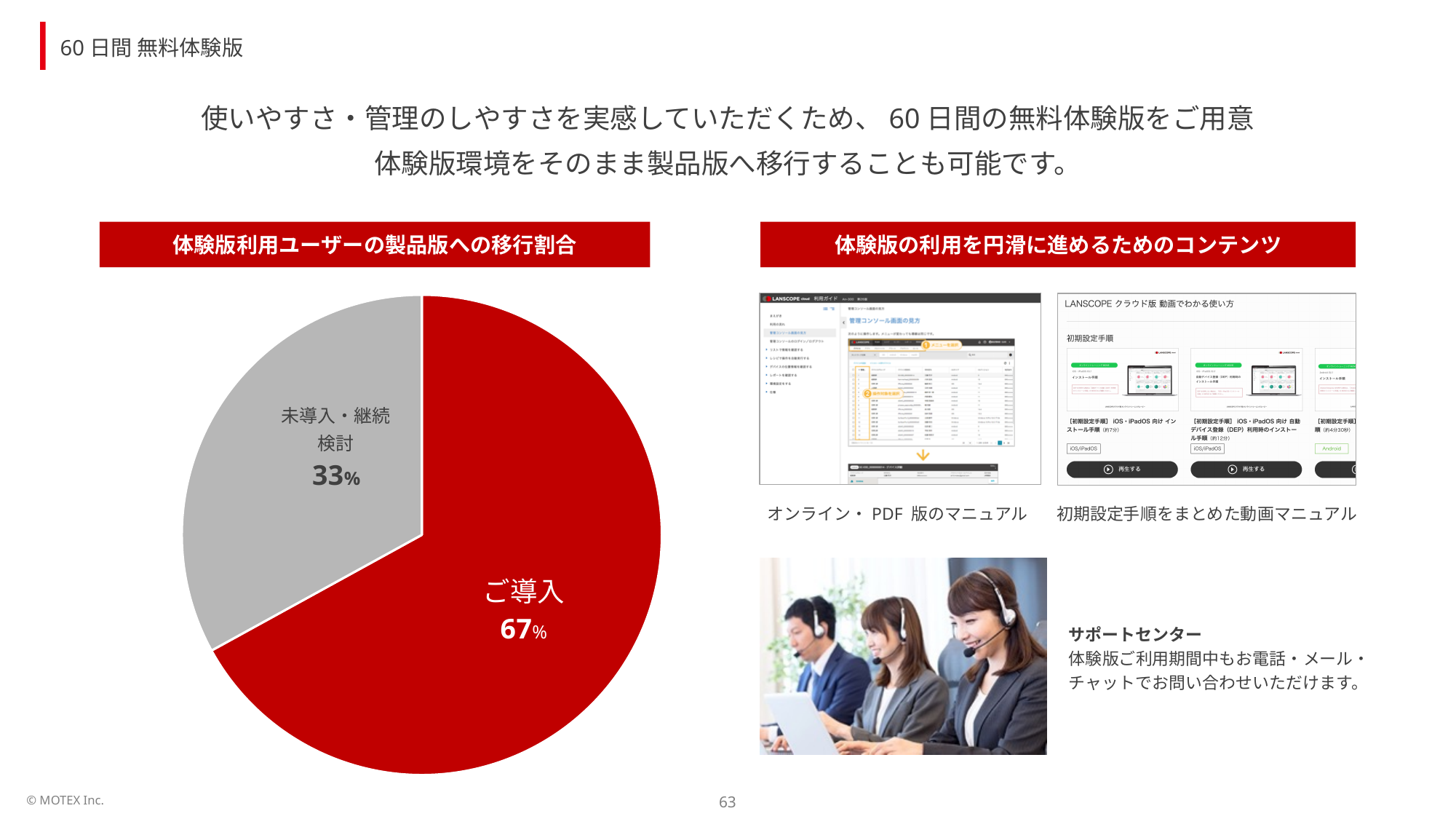
Which is larger, ご導入 or 未導入・継続検討? ご導入 Which slice of the pie chart is the smallest? 未導入・継続検討 What is the value for ご導入 in the pie chart? 67% What colour is the ご導入 slice of the pie chart? Red What share of the pie does the ご導入 slice represent? 67% Which slice of the pie chart is the largest? ご導入 How many slices does the pie chart have? 2 What is the title of the pie chart? 体験版利用ユーザーの製品版への移行割合 What is the difference between the ご導入 and 未導入・継続検討 slices? 34% What kind of chart is shown on the slide? Pie chart What is the value for 未導入・継続検討 in the pie chart? 33%